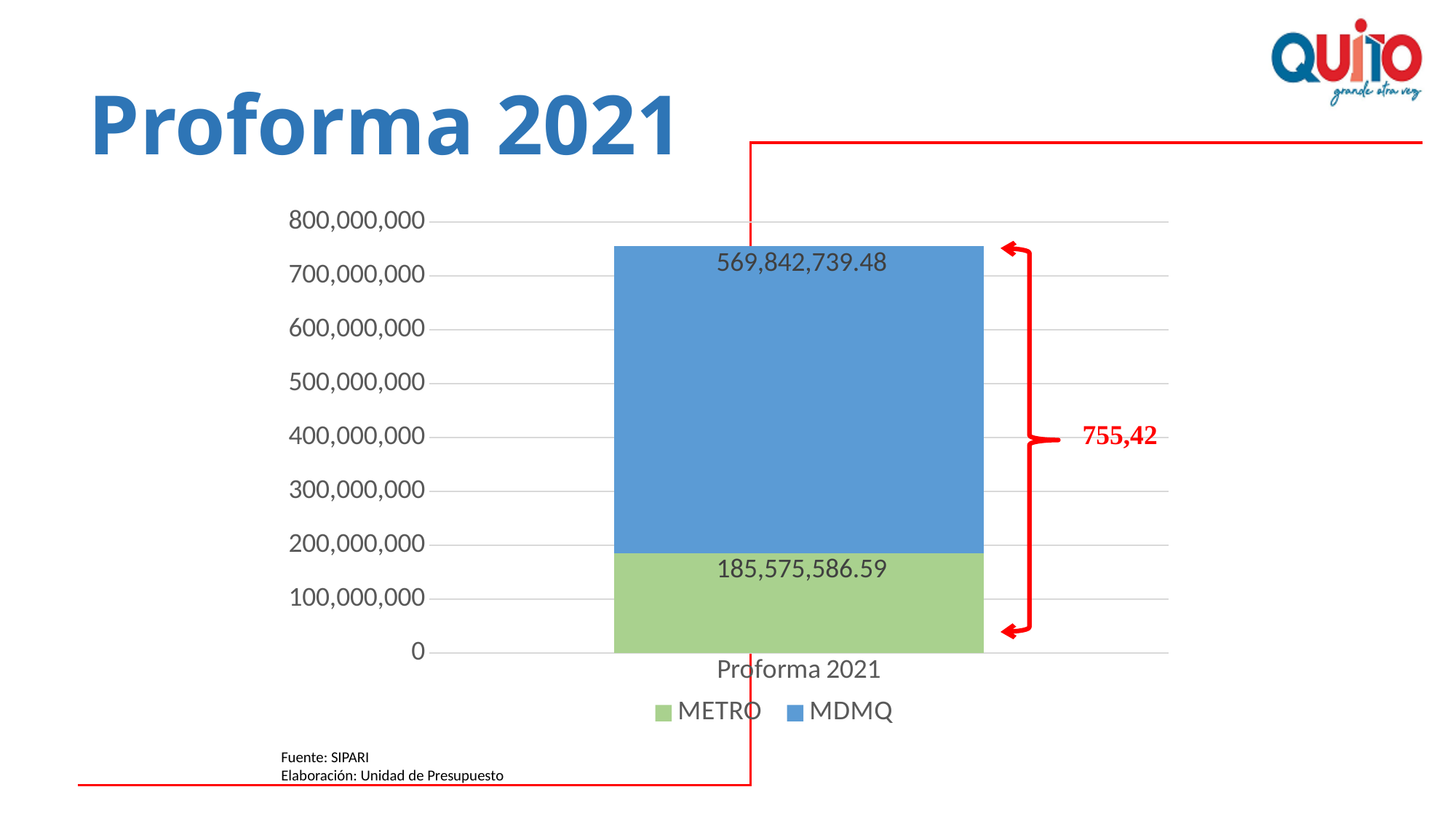
Is the value for METRO greater or less than 200,000,000? less What value does the red annotation next to the bar show? 755,42 What is the difference between the MDMQ value and the METRO value? 384,267,152.89 What kind of chart is shown on the slide? Stacked bar chart Which series has the smallest value in the chart? METRO How many series does the legend list? 2 Is the total height of the stacked bar greater or less than 700,000,000? greater What is the total of the stacked Proforma 2021 bar? 755,418,326.07 What is the value for METRO in the Proforma 2021 bar? 185,575,586.59 What is the value for MDMQ in the Proforma 2021 bar? 569,842,739.48 How many categories are shown on the x axis? 1 Which series has the larger value, METRO or MDMQ? MDMQ